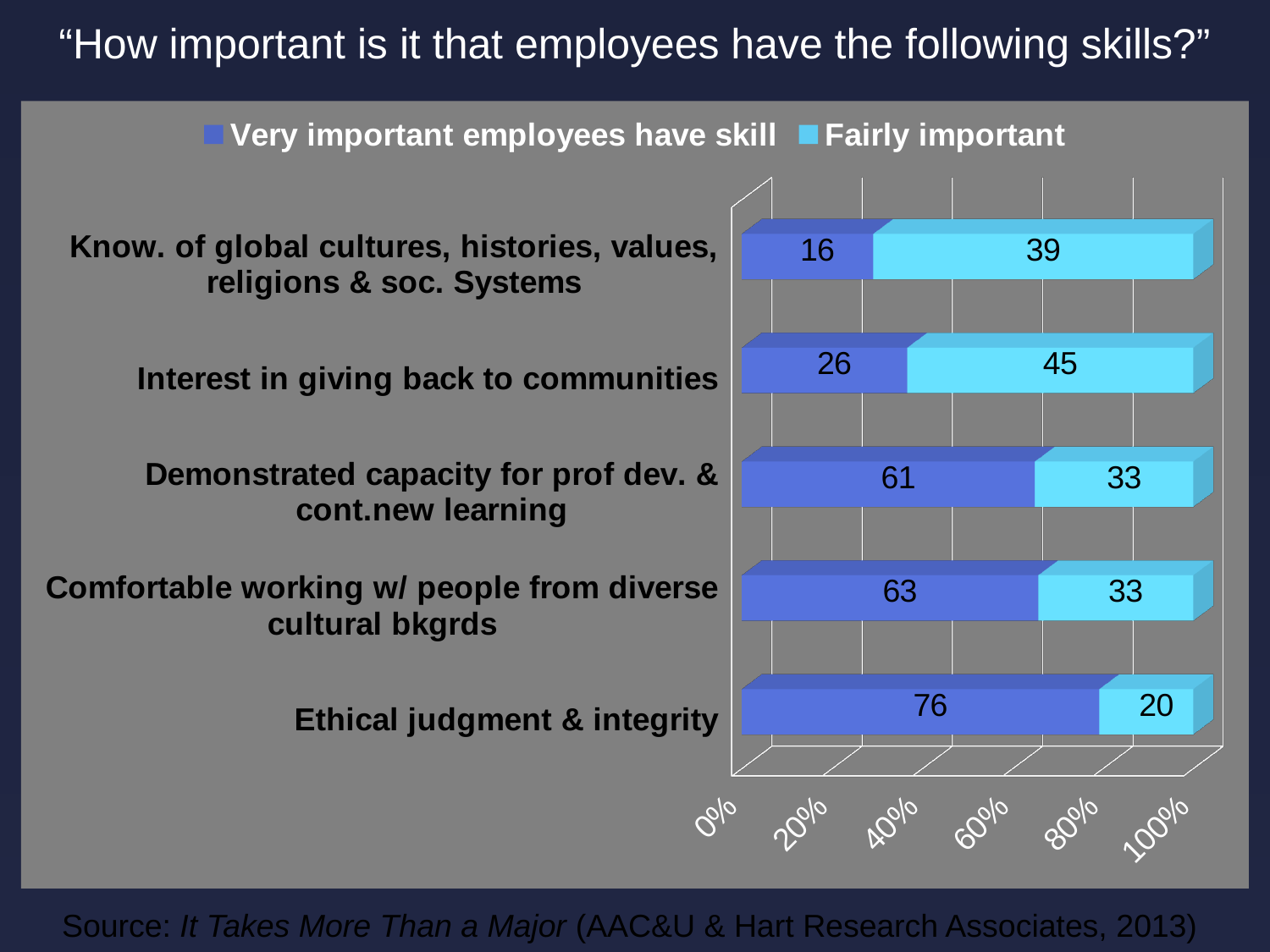
What is the 'Fairly important' value for 'Interest in giving back to communities'? 45 What is the total of the stacked bar for 'Demonstrated capacity for prof dev. & cont.new learning'? 94 What is the 'Very important employees have skill' value for 'Know. of global cultures, histories, values, religions & soc. Systems'? 16 How many series does the legend list? 2 Which category has the highest 'Very important employees have skill' value? Ethical judgment & integrity Which category has the lowest 'Fairly important' value? Ethical judgment & integrity What is the difference between the 'Very important employees have skill' values for 'Ethical judgment & integrity' and 'Interest in giving back to communities'? 50 What is the 'Very important employees have skill' value for 'Ethical judgment & integrity'? 76 Which is larger: the 'Very important employees have skill' value for 'Comfortable working w/ people from diverse cultural bkgrds' or for 'Interest in giving back to communities'? Comfortable working w/ people from diverse cultural bkgrds What kind of chart is shown on the slide? Stacked bar chart How many categories are shown in the chart? 5 Which category has the lowest 'Very important employees have skill' value? Know. of global cultures, histories, values, religions & soc. Systems